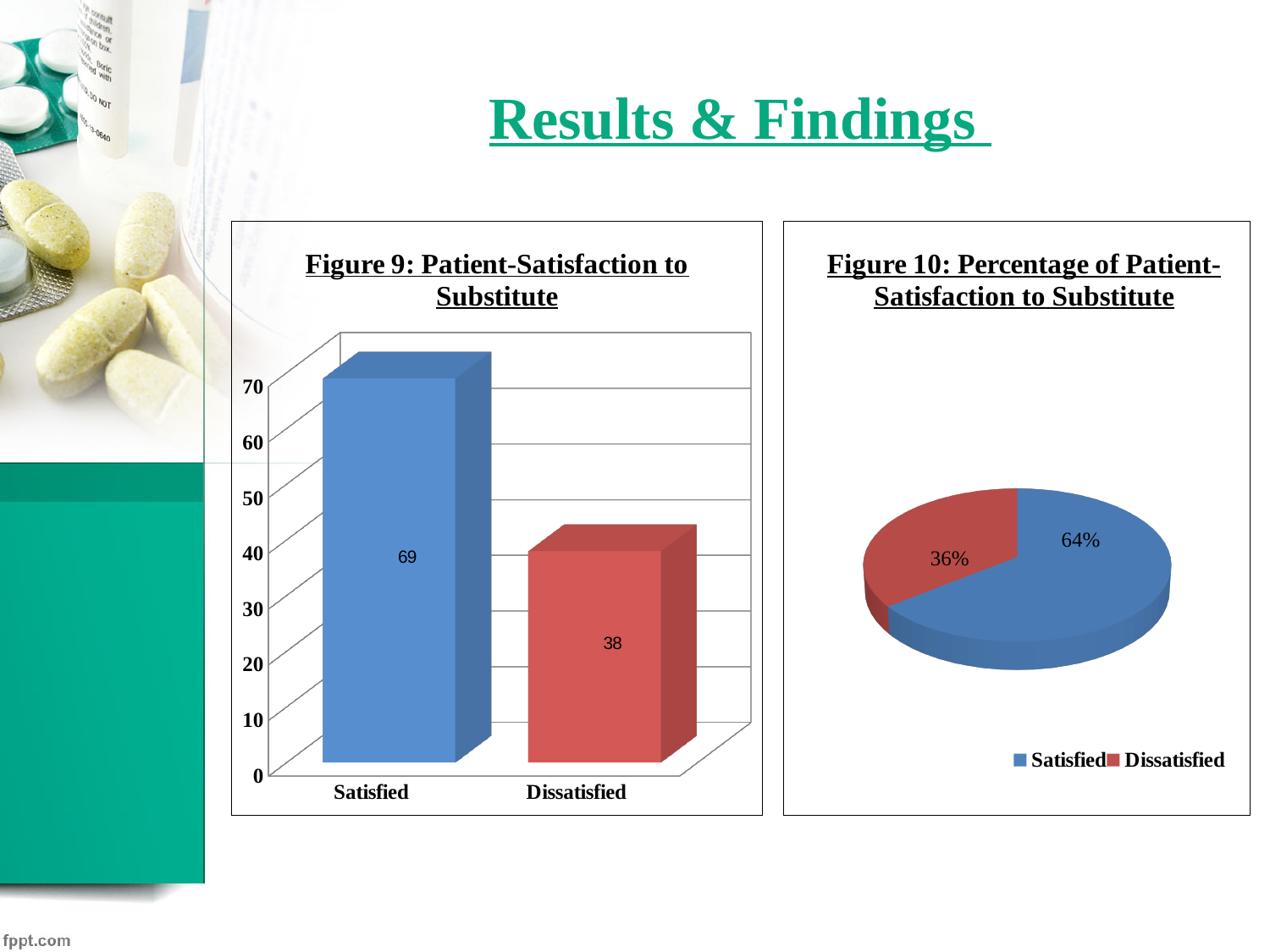
In Figure 9, what is the value for Satisfied? 69 In Figure 9, which category has the highest value? Satisfied In Figure 10, what share of the pie is Satisfied? 64% In Figure 9, what is the value for Dissatisfied? 38 What kind of chart is Figure 10? Pie chart In Figure 9, what is the difference between the Satisfied and Dissatisfied values? 31 In Figure 9, which category has the lowest value? Dissatisfied What kind of chart is Figure 9? Bar chart In Figure 9, is the value for Dissatisfied greater or less than 40? less In Figure 10, what share of the pie is Dissatisfied? 36% In Figure 9, how many categories are shown on the x axis? 2 In Figure 10, how many entries does the legend list? 2